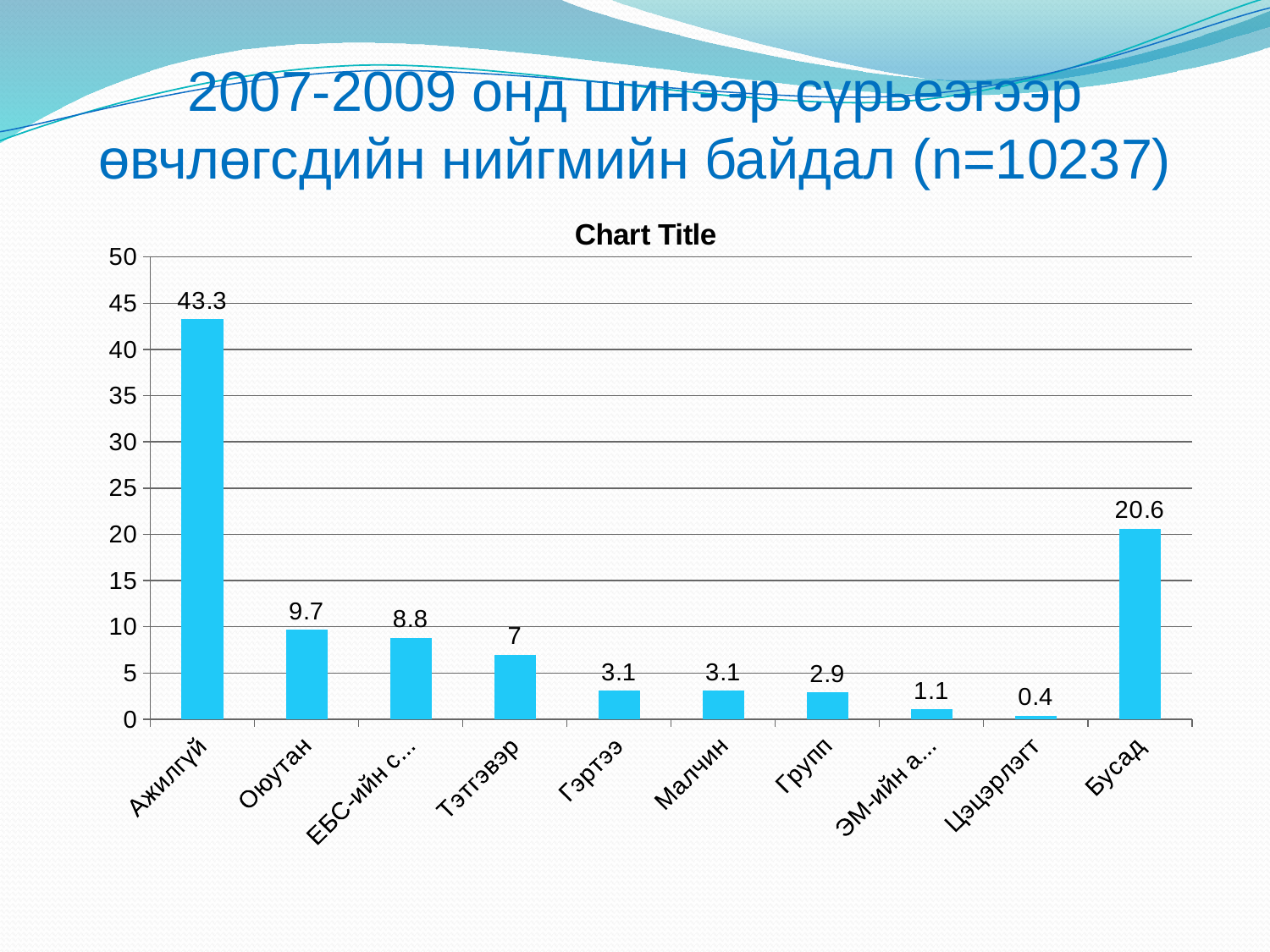
What is the value for Бусад? 20.6 What is the value for Цэцэрлэгт? 0.4 What is the value for Оюутан? 9.7 Which category has the highest value? Ажилгүй Which category has the lowest value? Цэцэрлэгт What kind of chart is shown on the slide? Bar chart What is the value for Ажилгүй? 43.3 What is the difference between the values for Ажилгүй and Бусад? 22.7 What is the title printed above the chart? Chart Title How many categories are shown on the x axis? 10 What is the value for Тэтгэвэр? 7 Which is larger, the value for Оюутан or the value for Тэтгэвэр? Оюутан